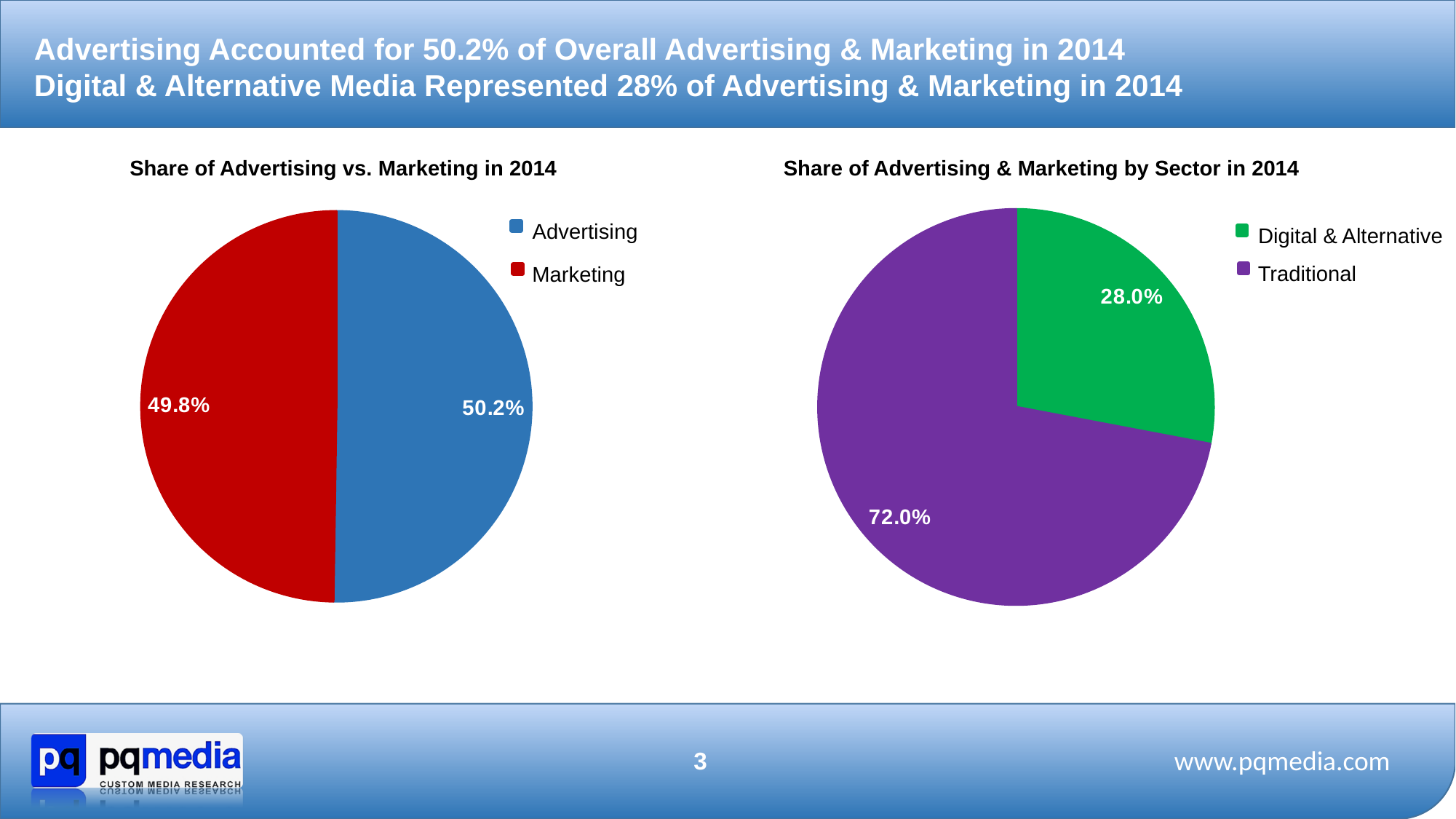
In the 'Share of Advertising vs. Marketing in 2014' chart, what share does Advertising have? 50.2% In the 'Share of Advertising vs. Marketing in 2014' chart, what share does Marketing have? 49.8% In the 'Share of Advertising & Marketing by Sector in 2014' chart, which sector has the largest slice? Traditional In the 'Share of Advertising & Marketing by Sector in 2014' chart, what share does Digital & Alternative have? 28.0% How many entries does the legend of the 'Share of Advertising vs. Marketing in 2014' chart list? 2 In the 'Share of Advertising vs. Marketing in 2014' chart, what is the difference in percentage points between Advertising and Marketing? 0.4 percentage points In the 'Share of Advertising & Marketing by Sector in 2014' chart, which sector has the smallest slice? Digital & Alternative In the 'Share of Advertising & Marketing by Sector in 2014' chart, what share does Traditional have? 72.0% What type of chart is 'Share of Advertising vs. Marketing in 2014'? Pie chart In the 'Share of Advertising & Marketing by Sector in 2014' chart, what is the difference in percentage points between Traditional and Digital & Alternative? 44.0 percentage points In the 'Share of Advertising & Marketing by Sector in 2014' chart, what colour is the Traditional slice? Purple How many slices does the 'Share of Advertising & Marketing by Sector in 2014' chart have? 2